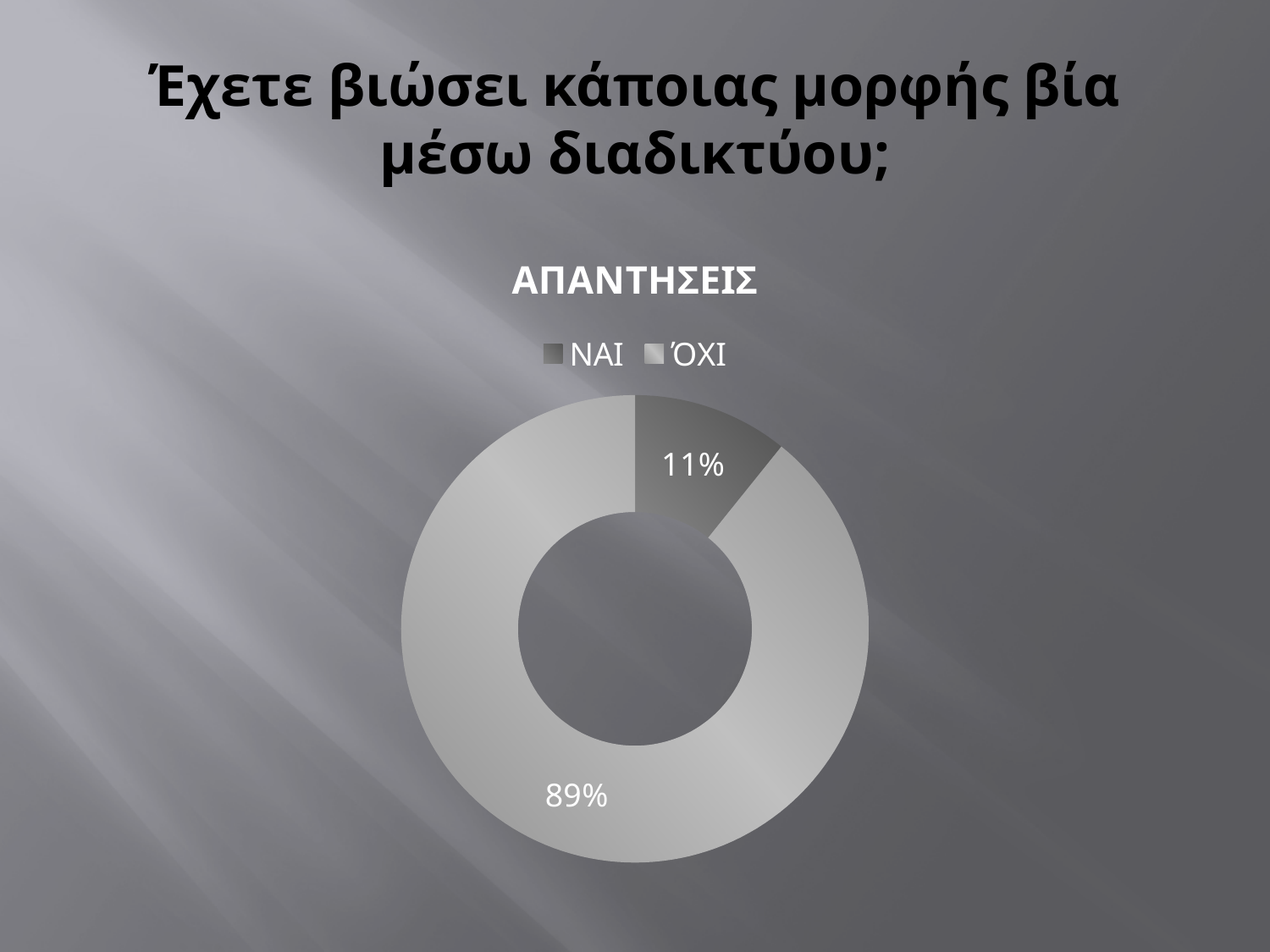
Which category has the largest share? ΌΧΙ Which category has the smallest share? ΝΑΙ What share of the chart does ΌΧΙ represent? 89% What is the title of the chart? ΑΠΑΝΤΗΣΕΙΣ How many categories does the chart show? 2 What kind of chart is shown on the slide? Doughnut (pie) chart What share of the chart does ΝΑΙ represent? 11% Which legend entry is shown in the darker grey colour? ΝΑΙ Which is larger, the share for ΝΑΙ or the share for ΌΧΙ? ΌΧΙ How many entries does the legend list? 2 What is the difference in percentage points between ΌΧΙ and ΝΑΙ? 78